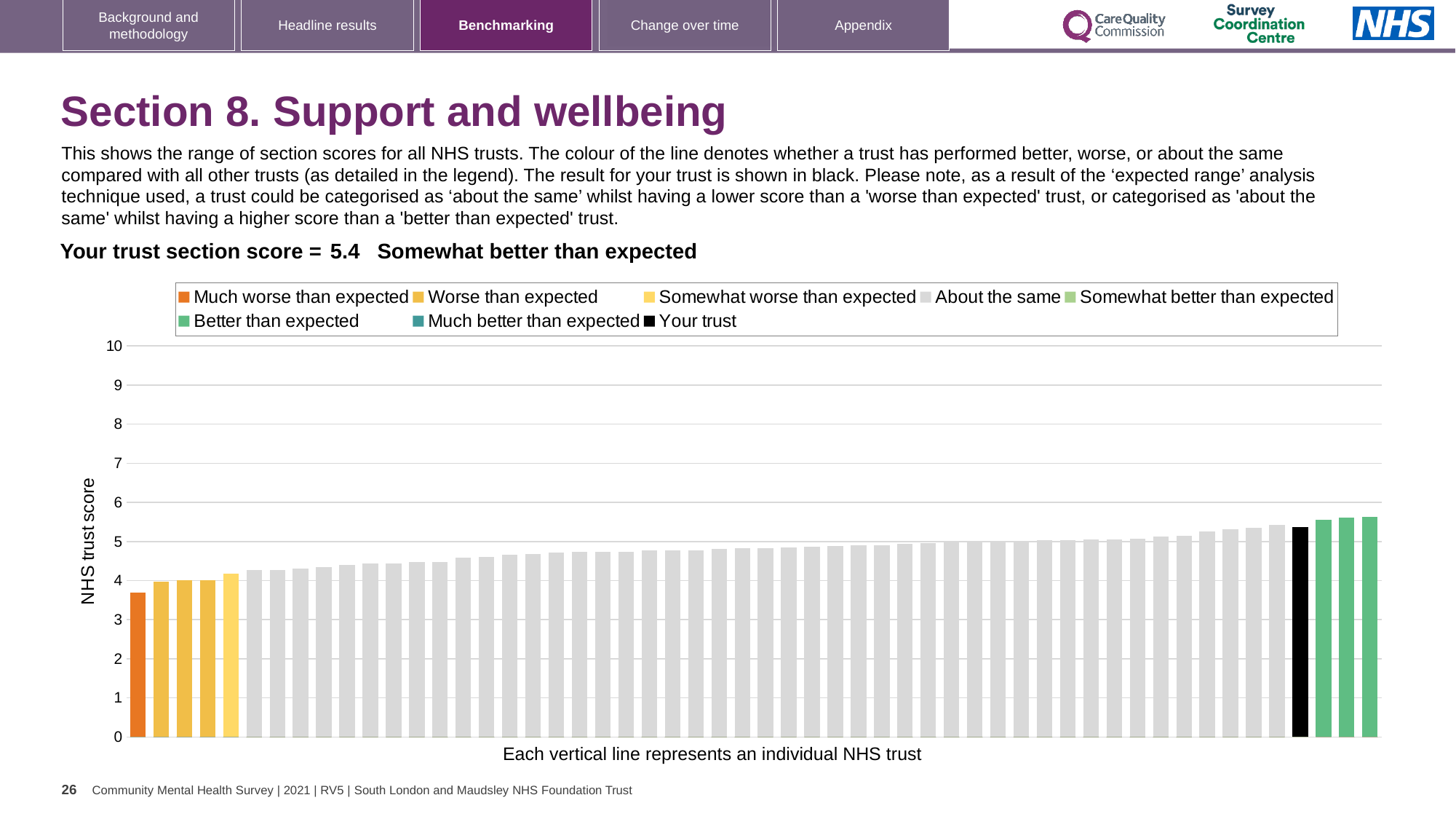
Do the bar values rise or fall from left to right along the x axis? rise Is the value of the black 'Your trust' bar greater or less than 5? greater How many bars are coloured green ('Better than expected')? 3 Which legend category does the shortest bar in the chart belong to? Much worse than expected Is the value of the lowest bar (the orange 'Much worse than expected' bar) greater or less than 4? less What is the label on the vertical axis of the chart? NHS trust score How many bars are coloured orange ('Much worse than expected')? 1 What kind of chart is shown on the slide? bar chart What is the section score for your trust shown on the slide? 5.4 Which legend category does the tallest bar in the chart belong to? Better than expected Is the value of the highest bar in the chart greater or less than 6? less How many entries does the chart legend list? 8